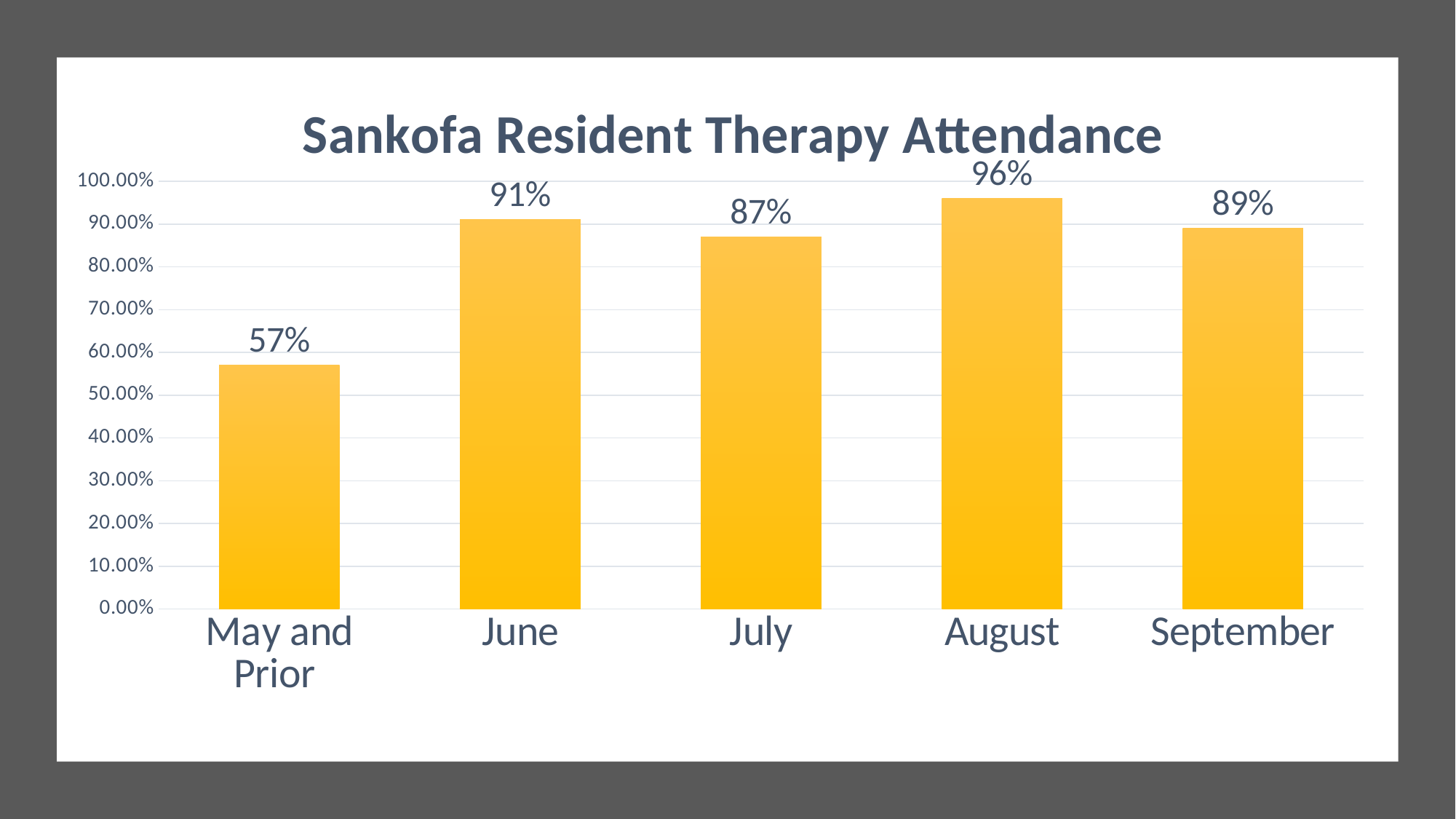
Which is larger, the attendance for June or for September? June Which category has the lowest therapy attendance? May and Prior Which month has the highest therapy attendance? August What kind of chart is shown on the slide? Bar chart What is the therapy attendance value for September? 89% Is the value for May and Prior greater or less than 60.00%? less What is the title of the chart? Sankofa Resident Therapy Attendance What is the difference between the attendance in August and in July? 9% How many categories are shown on the x axis? 5 What is the therapy attendance value for June? 91% What is the therapy attendance value for May and Prior? 57% What is the difference between the attendance in June and in May and Prior? 34%